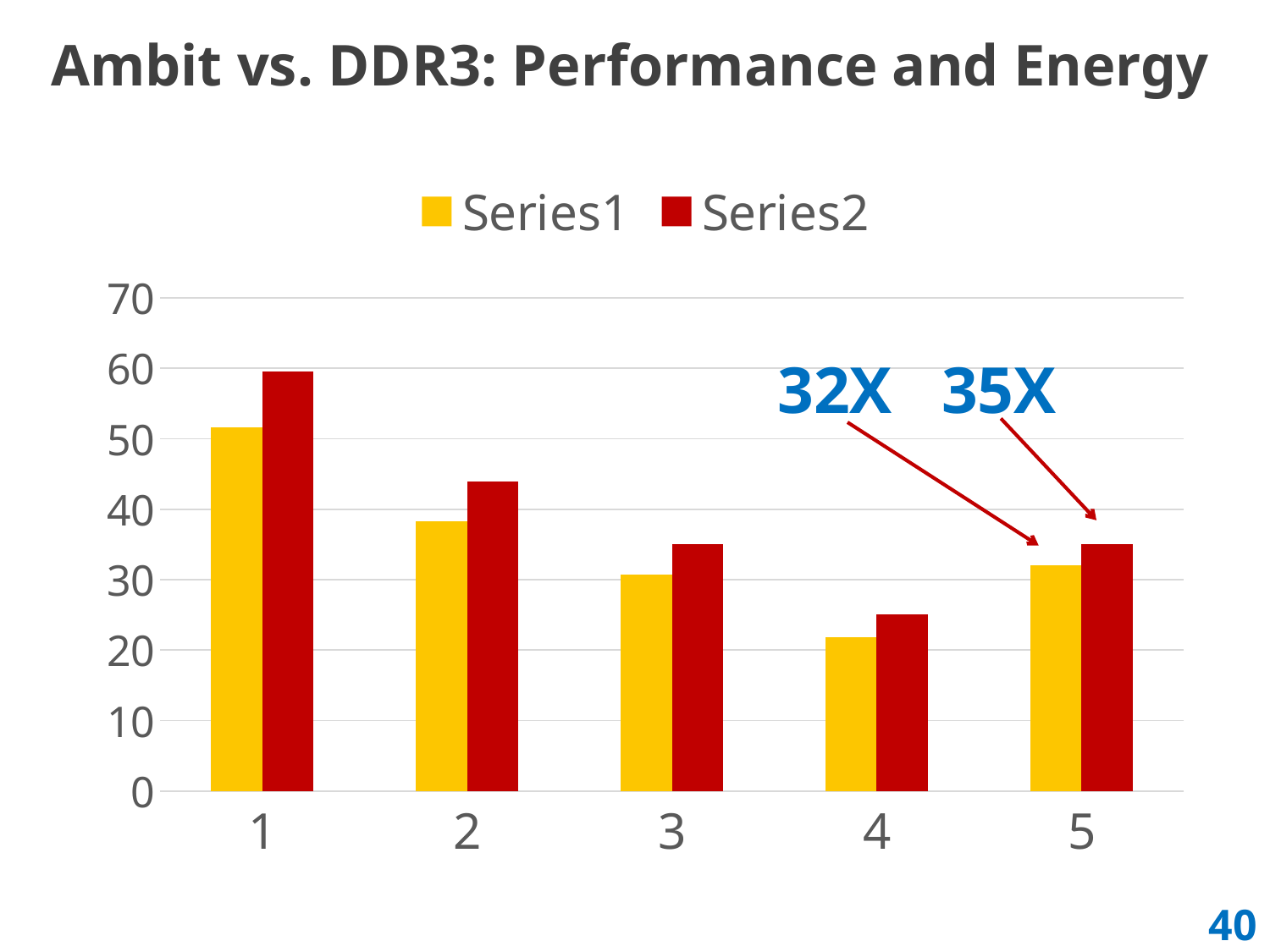
In category 1, which series has the larger value, Series1 or Series2? Series2 Which series is shown in red in the chart? Series2 Is the Series2 value for category 1 greater or less than 50? greater Which category has the highest Series2 value? 1 What kind of chart is shown on the slide? bar chart What annotation points to the Series1 bar for category 5? 32X What annotation points to the Series2 bar for category 5? 35X Which category has the lowest Series1 value? 4 What is the title of the slide containing the chart? Ambit vs. DDR3: Performance and Energy How many series does the chart's legend list? 2 Is the Series1 value for category 4 greater or less than 30? less How many categories are shown on the x axis of the chart? 5